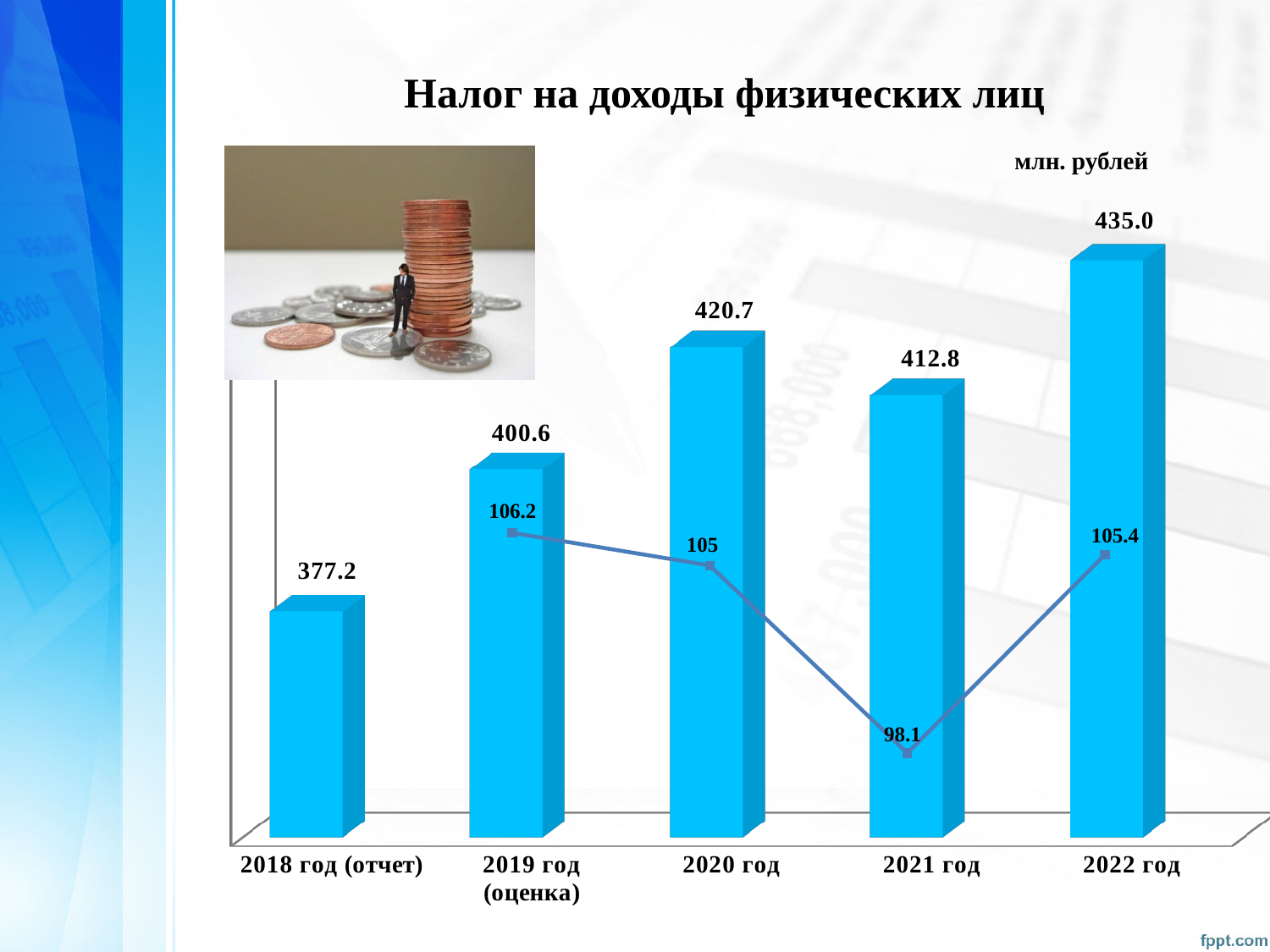
Which year has the highest bar value? 2022 год What unit is indicated for the bar values on the chart? млн. рублей How many years are shown on the x axis? 5 What is the value of the bar for 2022 год? 435.0 What is the line value shown for 2021 год? 98.1 What is the difference between the bar values for 2022 год and 2018 год (отчет)? 57.8 What is the title of the chart? Налог на доходы физических лиц What is the value of the bar for 2020 год? 420.7 What is the value of the bar for 2018 год (отчет)? 377.2 Which is larger, the bar value for 2020 год or for 2021 год? 2020 год What is the line value shown for 2019 год (оценка)? 106.2 Which year has the lowest bar value? 2018 год (отчет)